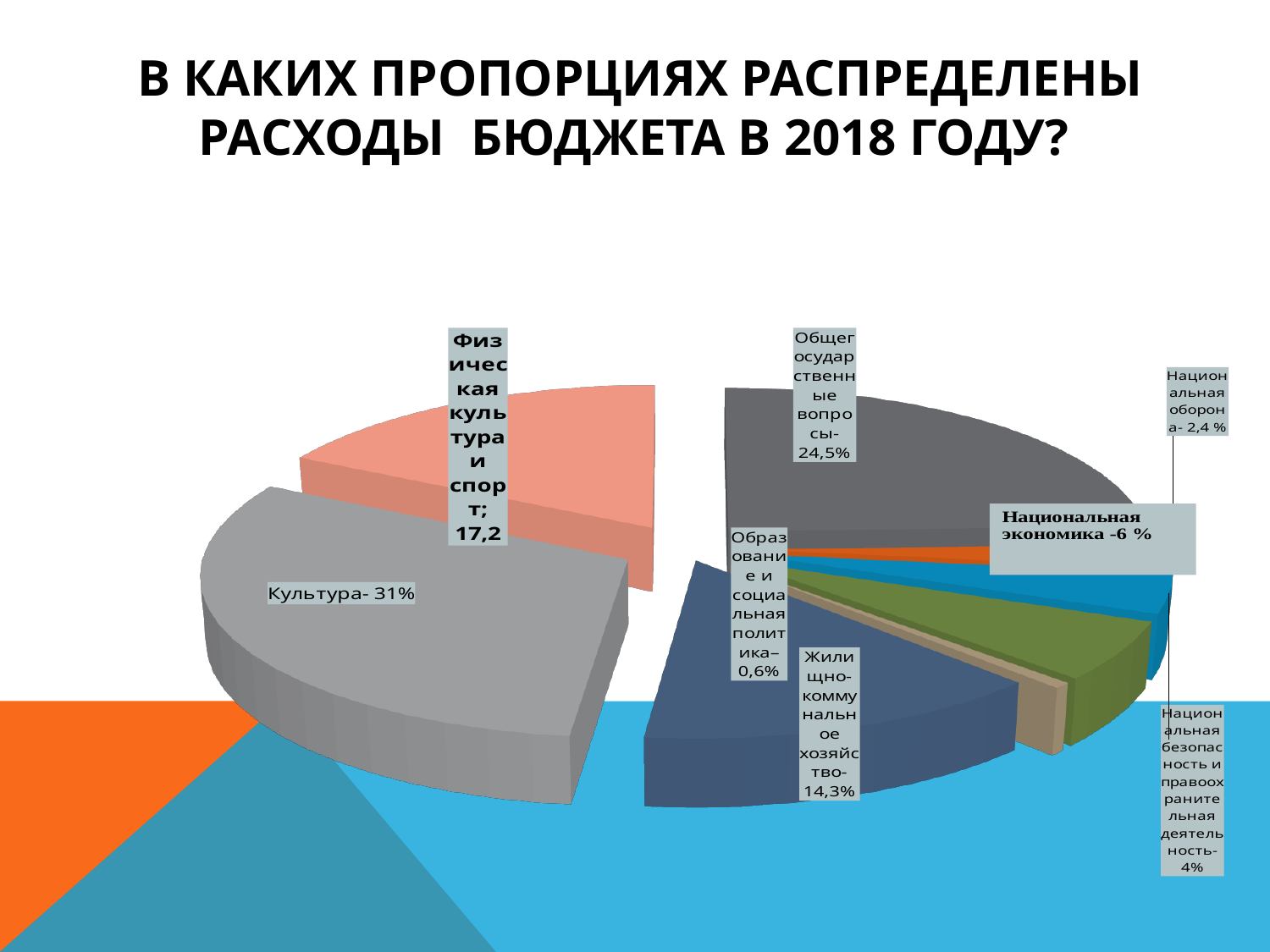
What year does the chart title say the budget expenditures refer to? 2018 What share is shown for Жилищно-коммунальное хозяйство? 14,3% What kind of chart is shown on the slide? pie chart Which category has the smallest share of the pie? Образование и социальная политика What share is shown for Национальная оборона? 2,4 % What share is shown for Образование и социальная политика? 0,6% Which category has the largest share of the pie? Культура What share is shown for Национальная экономика? 6 % What share is shown for Общегосударственные вопросы? 24,5% Which is larger: the share for Общегосударственные вопросы or the share for Жилищно-коммунальное хозяйство? Общегосударственные вопросы How many categories (slices) does the pie chart show? 8 What share of the budget expenditure goes to Культура? 31%